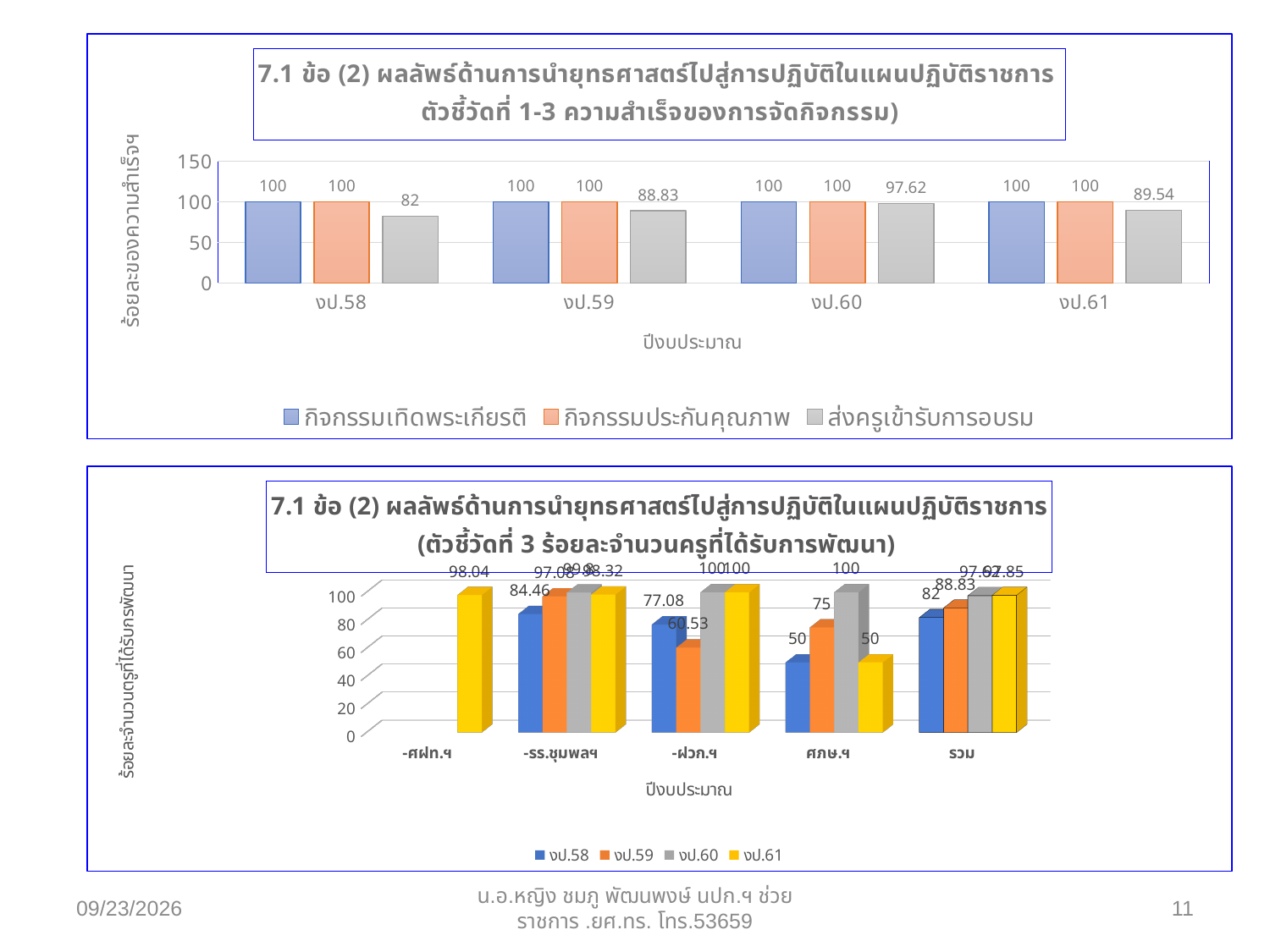
In the top chart, what is the value for กิจกรรมประกันคุณภาพ in งป.61? 100 In the bottom chart, what is the value for งป.59 at ฝวก.ฯ? 60.53 In the bottom chart, what is the difference between งป.60 and งป.58 at ฝวก.ฯ? 22.92 In the top chart, which year has the lowest value for ส่งครูเข้ารับการอบรม? งป.58 In the bottom chart, which is larger at ศภษ.ฯ: งป.59 or งป.61? งป.59 In the top chart, how many series does the legend list? 3 In the top chart, what is the value for ส่งครูเข้ารับการอบรม in งป.60? 97.62 What type of chart is the bottom chart? Bar chart In the top chart, what is the difference between กิจกรรมเทิดพระเกียรติ and ส่งครูเข้ารับการอบรม in งป.59? 11.17 In the top chart, how many years are shown on the x axis? 4 In the top chart, what is the value for ส่งครูเข้ารับการอบรม in งป.58? 82 In the bottom chart, what is the value for งป.58 at ศภษ.ฯ? 50